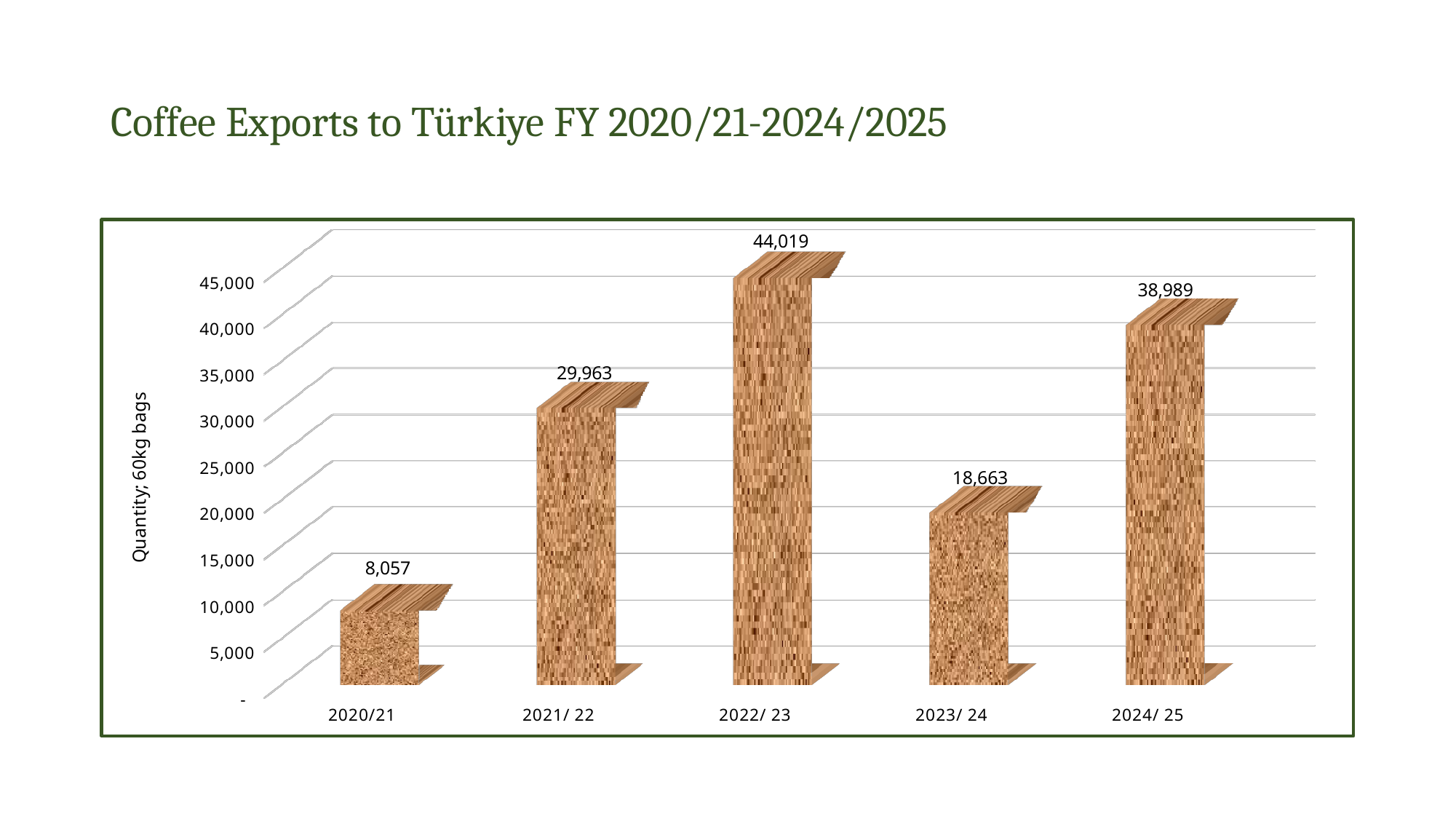
What is the value for 2022/ 23? 44,019 What kind of chart is shown on the slide? bar chart What is the value for 2020/21? 8,057 Which fiscal year has the lowest value? 2020/21 Which fiscal year has the highest value? 2022/ 23 How many fiscal years are shown on the chart? 5 What is the value for 2024/ 25? 38,989 What is the value for 2023/ 24? 18,663 What is the difference between the values for 2022/ 23 and 2024/ 25? 5,030 Which is larger, the value for 2021/ 22 or the value for 2023/ 24? 2021/ 22 What is the difference between the values for 2021/ 22 and 2020/21? 21,906 What is the label of the vertical axis? Quantity; 60kg bags